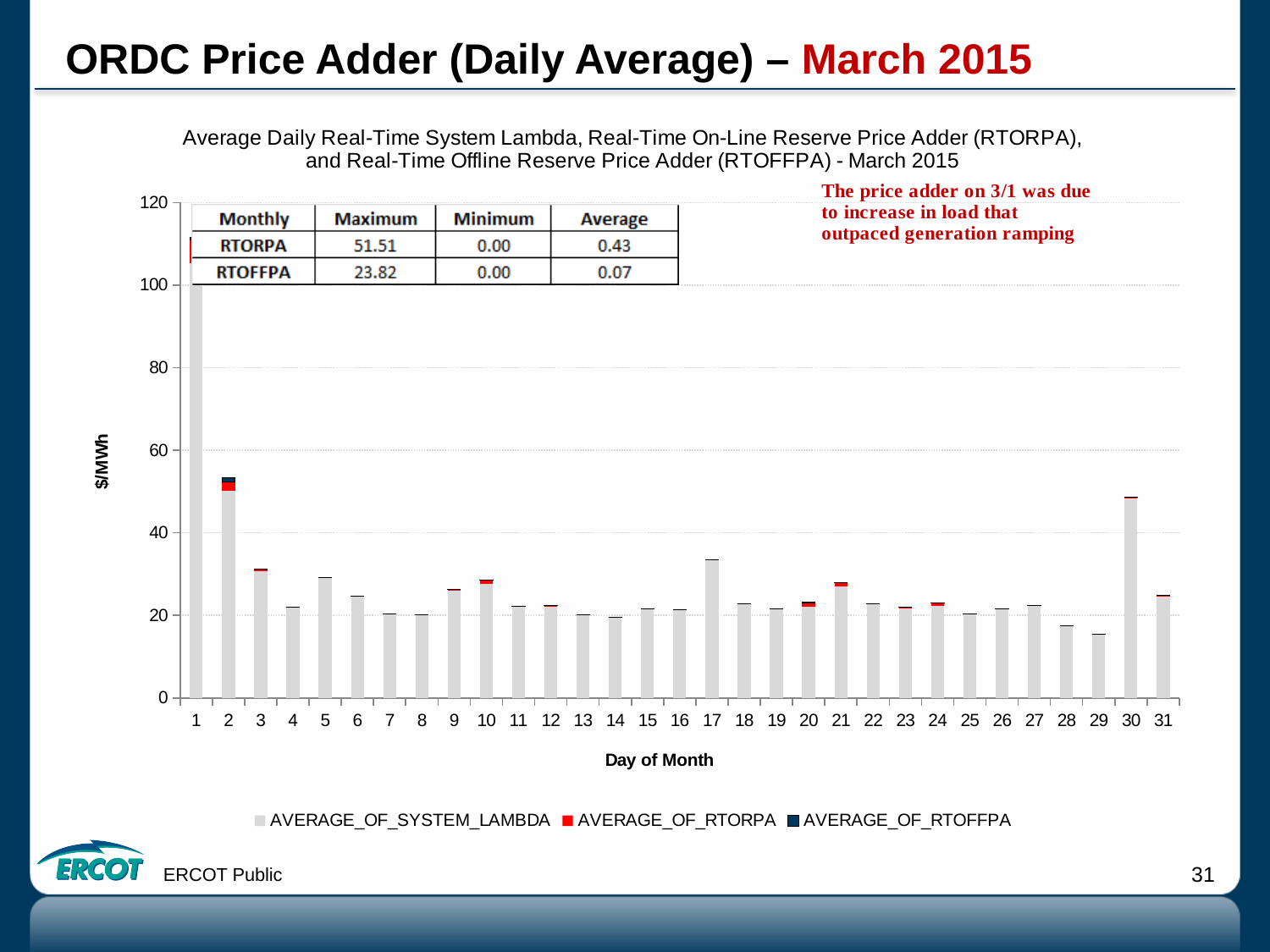
How many series does the legend list? 3 Which day of the month has the highest total bar? 1 Is the total bar for day 17 greater or less than 20? greater Which day of the month has the lowest total bar? 29 Is the total bar for day 30 greater or less than 60? less Is the total bar for day 1 greater or less than 100? greater How many days of the month are plotted on the x axis? 31 Which day has the taller total bar, day 5 or day 4? day 5 What kind of chart is shown on the slide? bar chart Which day has the taller total bar, day 2 or day 30? day 2 What is the label on the y axis of the chart? $/MWh